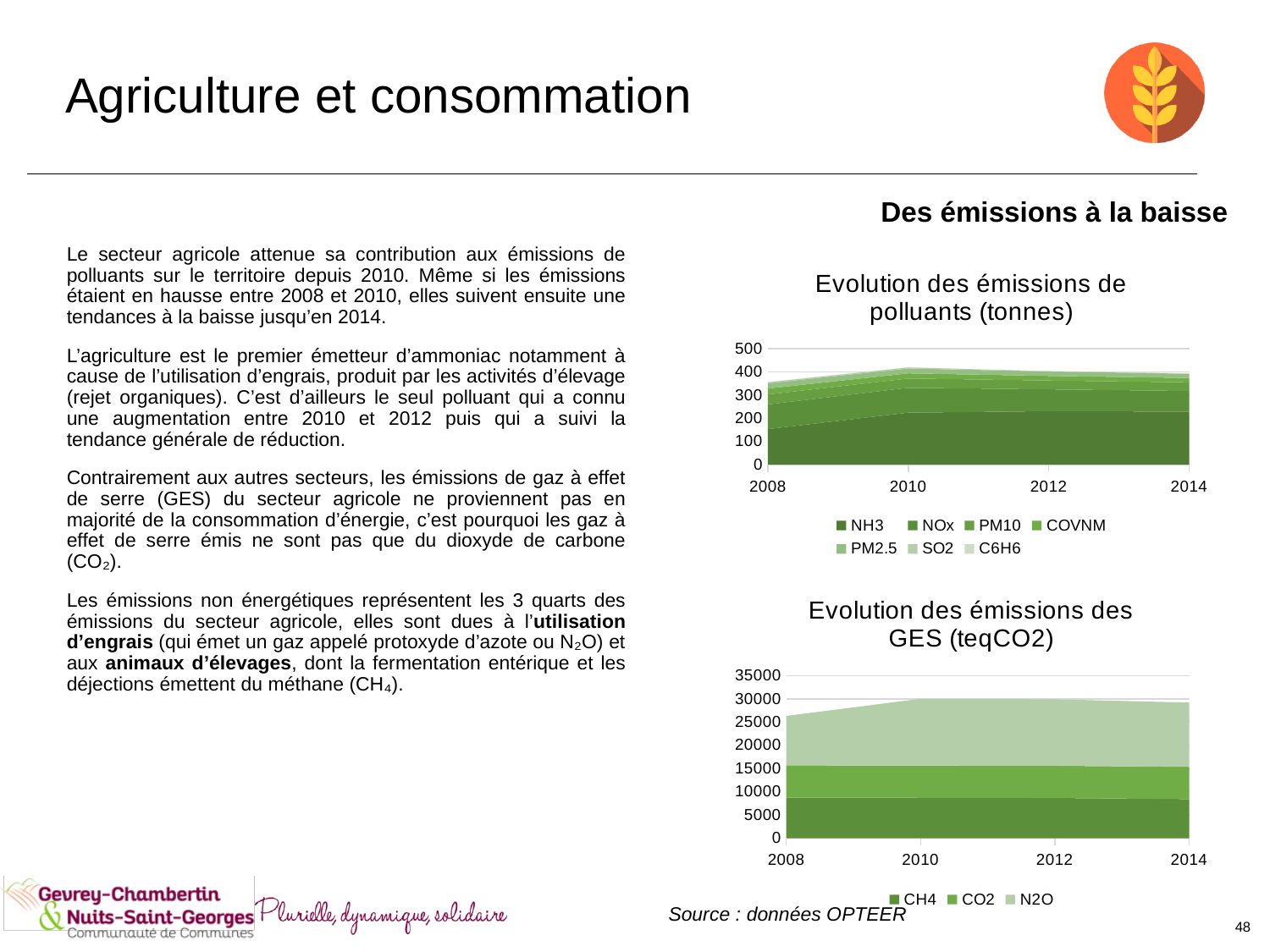
In 'Evolution des émissions de polluants (tonnes)', is the NH3 value for 2008 greater or less than 200? less In 'Evolution des émissions de polluants (tonnes)', is the total stacked value for 2008 greater or less than 500? less In 'Evolution des émissions des GES (teqCO2)', is the CH4 value for 2014 greater or less than 10000? less In 'Evolution des émissions de polluants (tonnes)', is the total stacked value larger in 2008 or in 2010? 2010 How many series does the legend of 'Evolution des émissions des GES (teqCO2)' list? 3 What type of chart is 'Evolution des émissions de polluants (tonnes)'? stacked area chart What is the title of the lower chart on the slide? Evolution des émissions des GES (teqCO2) How many series does the legend of 'Evolution des émissions de polluants (tonnes)' list? 7 How many years are shown on the x axis of 'Evolution des émissions de polluants (tonnes)'? 4 In 'Evolution des émissions de polluants (tonnes)', does the total stacked value rise or fall between 2010 and 2014? fall In 'Evolution des émissions des GES (teqCO2)', which series has the largest band in 2014? N2O